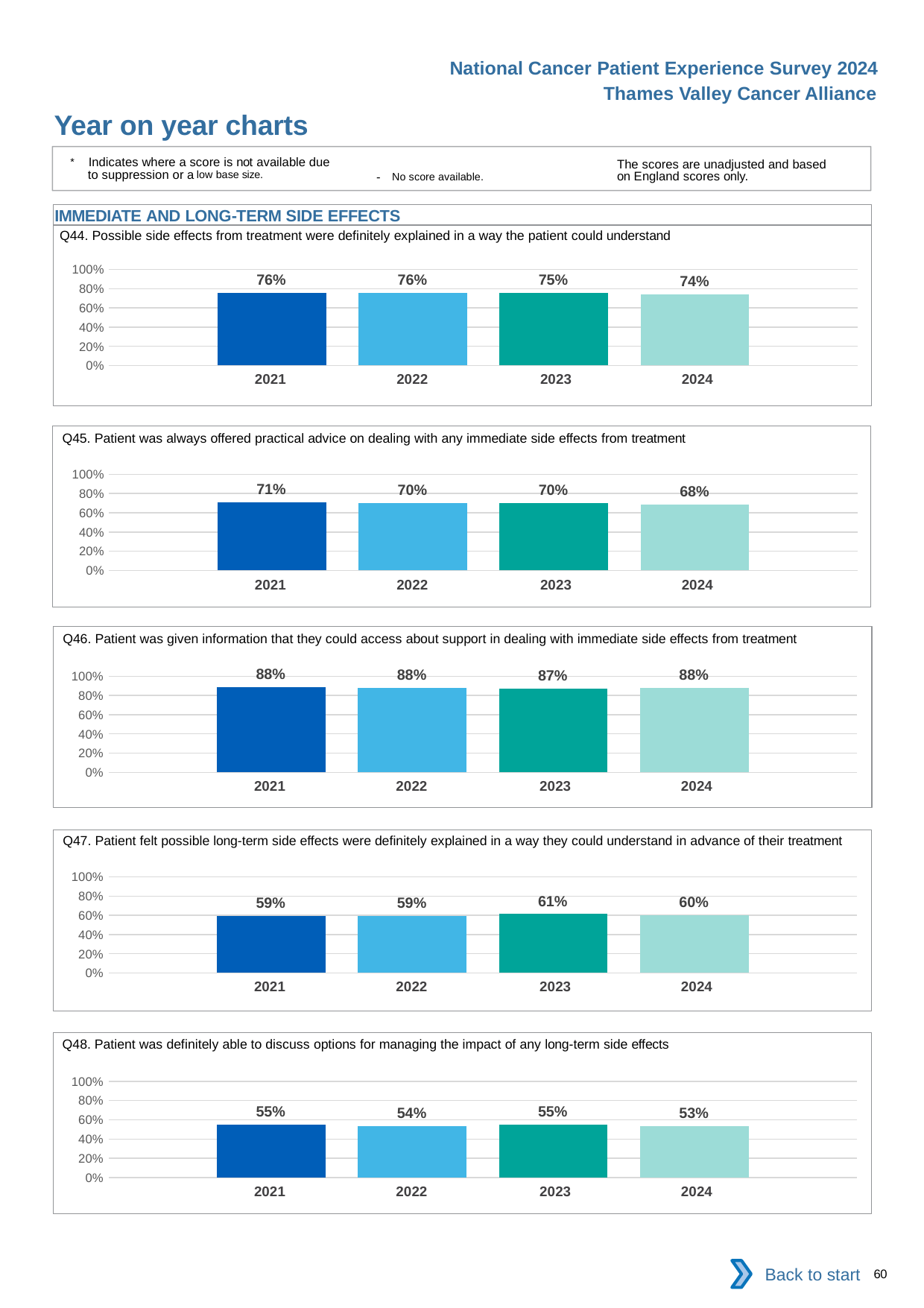
In the Q47 chart, is the value for 2022 larger or smaller than the value for 2023? smaller In the Q48 chart, what is the value for 2022? 54% In the Q45 chart, which year has the lowest value? 2024 In the Q44 chart, what is the value for 2024? 74% What kind of chart is the Q46 chart? bar chart In the Q45 chart, what is the difference between the 2021 and 2024 values? 3 percentage points In the Q48 chart, what is the difference between the 2023 and 2024 values? 2 percentage points In the Q47 chart, which year has the highest value? 2023 What is the section heading above the Q44 chart? IMMEDIATE AND LONG-TERM SIDE EFFECTS In the Q44 chart, do the values rise or fall from 2021 to 2024? fall How many years are shown in the Q44 chart? 4 In the Q46 chart, what is the value for 2023? 87%